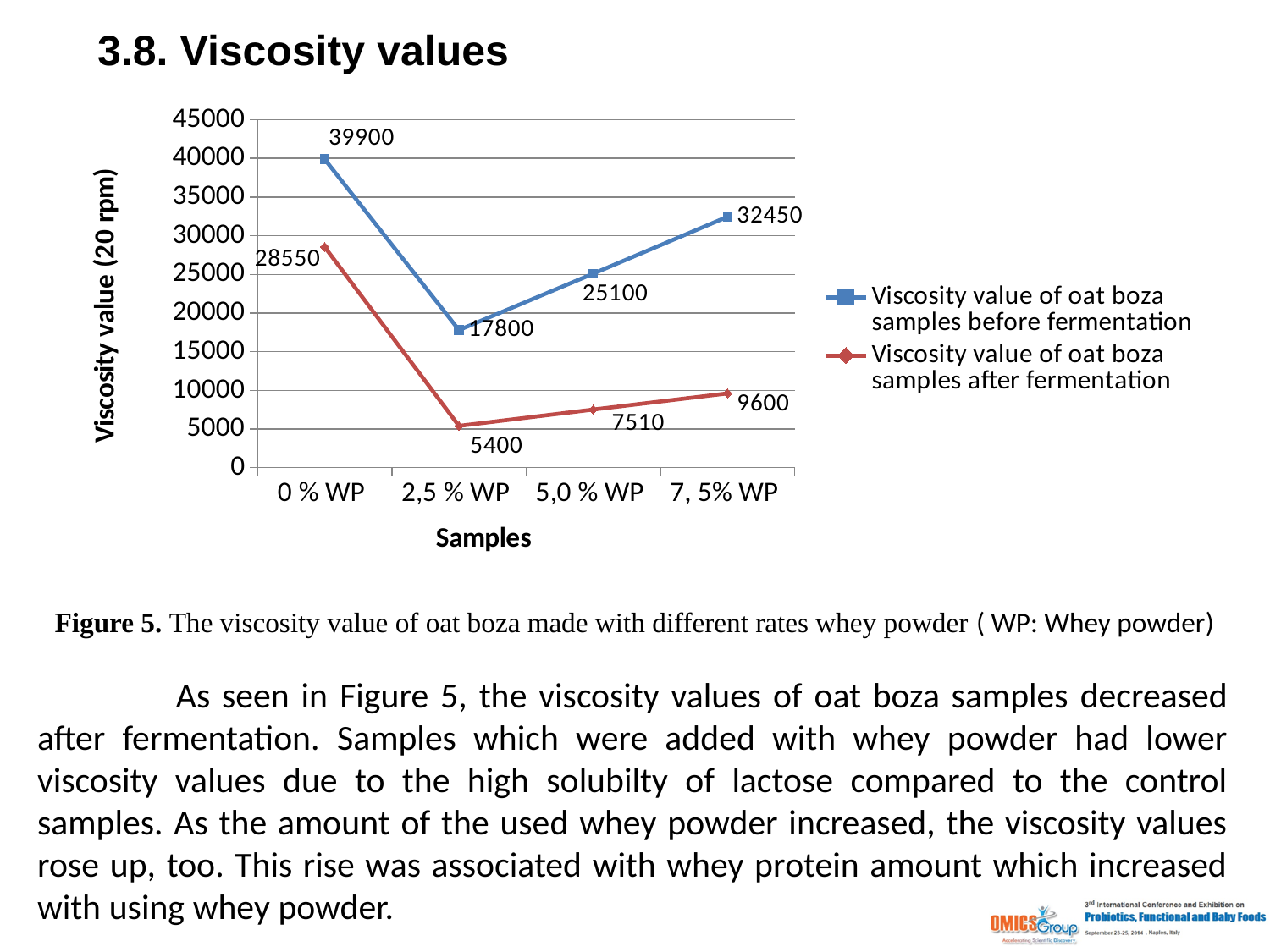
What is the difference between the viscosity values before and after fermentation at 0 % WP? 11350 What is the viscosity value of oat boza samples after fermentation at 5,0 % WP? 7510 Which sample has the lowest viscosity value before fermentation? 2,5 % WP What is the viscosity value of oat boza samples before fermentation at 0 % WP? 39900 Which sample has the highest viscosity value after fermentation? 0 % WP What is the viscosity value of oat boza samples before fermentation at 7, 5% WP? 32450 What is the viscosity value of oat boza samples after fermentation at 2,5 % WP? 5400 Which is larger: the viscosity value before fermentation at 5,0 % WP or at 7, 5% WP? 7, 5% WP Is the viscosity value after fermentation at 7, 5% WP greater or less than 10000? less What kind of chart is shown on the slide? line chart How many series does the legend list? 2 How many samples are shown on the x axis? 4